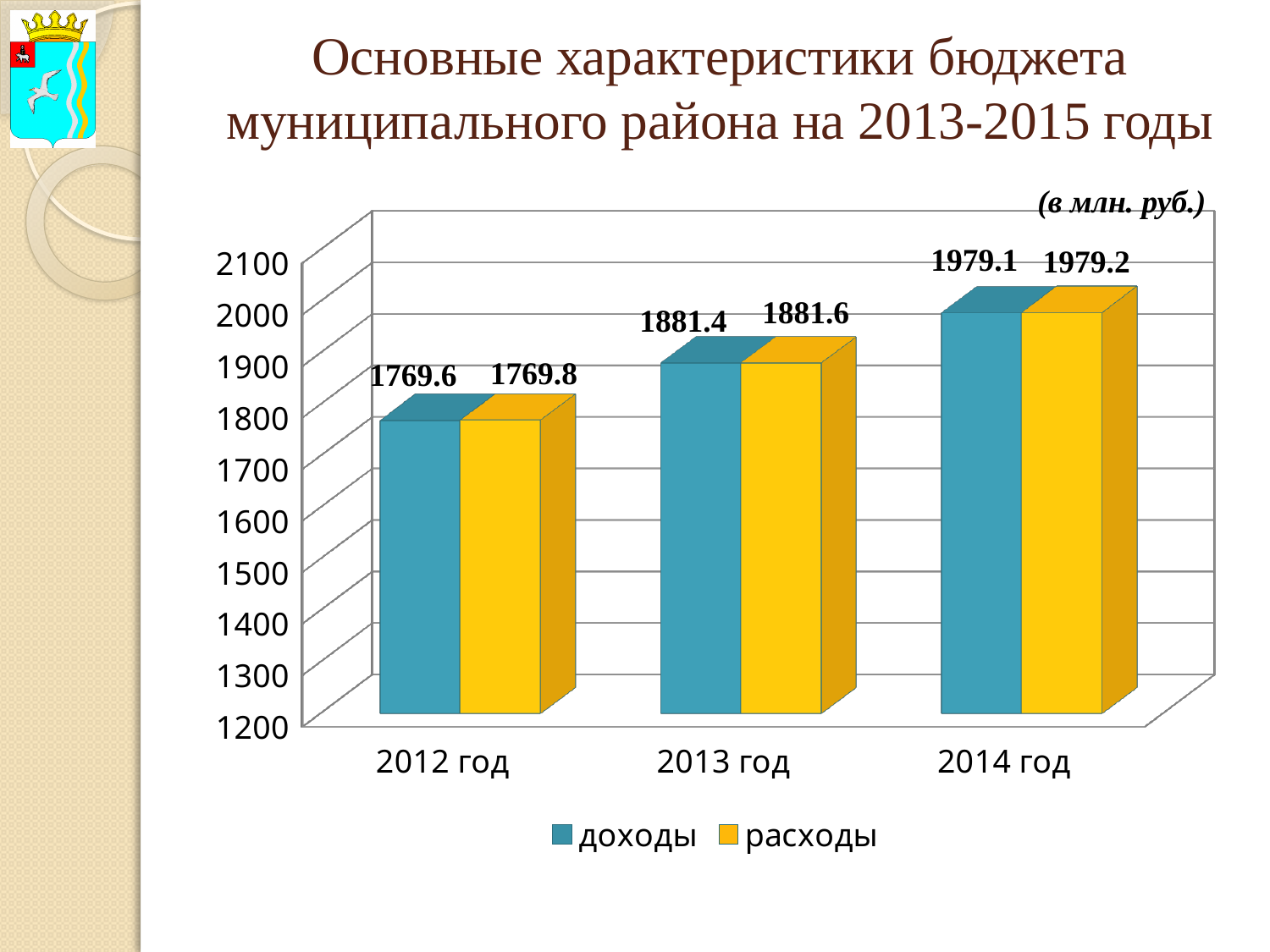
Which is larger: расходы in 2013 год or расходы in 2012 год? расходы in 2013 год How many series does the legend list? 2 What is the difference between доходы in 2014 год and доходы in 2013 год? 97.7 How many years are shown on the x axis? 3 Which year has the highest value of доходы? 2014 год What is the value of доходы for 2014 год? 1979.1 What is the value of расходы for 2013 год? 1881.6 What kind of chart is shown on the slide? bar chart Which year has the lowest value of расходы? 2012 год What is the value of доходы for 2012 год? 1769.6 What is the value of расходы for 2012 год? 1769.8 Do the values of доходы rise or fall from 2012 год to 2014 год? rise